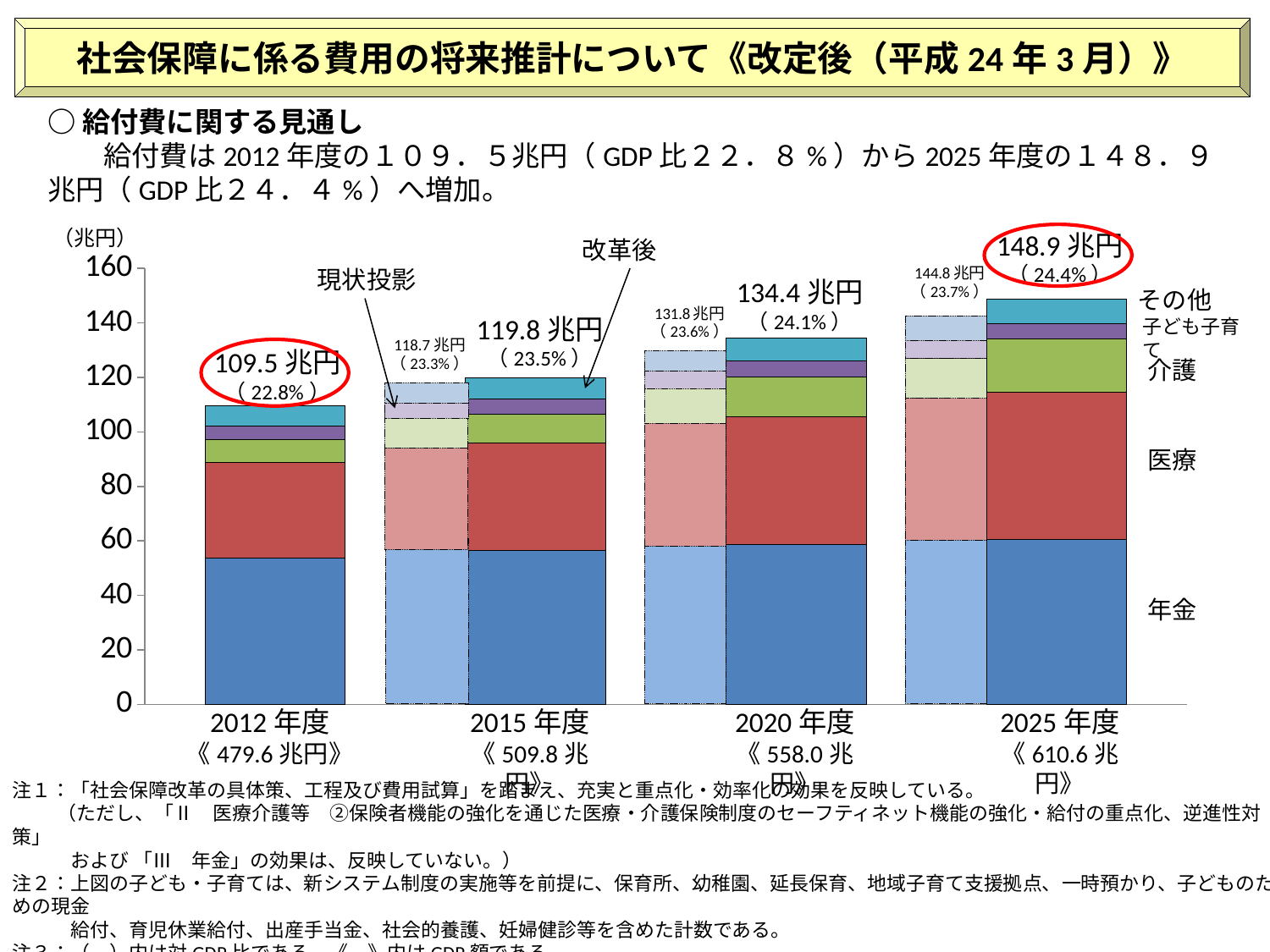
Is the 年金 segment of the 2012年度 bar greater or less than 60? less How many fiscal years are shown on the x axis? 4 Which year has the lowest total benefit cost? 2012年度 What is the total benefit cost shown for 2012年度? 109.5 兆円 What is the difference between the 改革後 and 現状投影 totals in 2025年度? 4.1 兆円 What GDP ratio is shown for the 改革後 bar in 2020年度? 24.1% What is the difference between the 改革後 total in 2025年度 and the total in 2012年度? 39.4 兆円 What is the total benefit cost for the 現状投影 bar in 2020年度? 131.8 兆円 What kind of chart is this? Stacked bar chart Which bar has the highest total benefit cost? 2025年度 改革後 (148.9 兆円) Which is larger, the 改革後 total in 2015年度 or the 現状投影 total in 2015年度? 改革後 (119.8 兆円) What is the total benefit cost for the 改革後 bar in 2025年度? 148.9 兆円